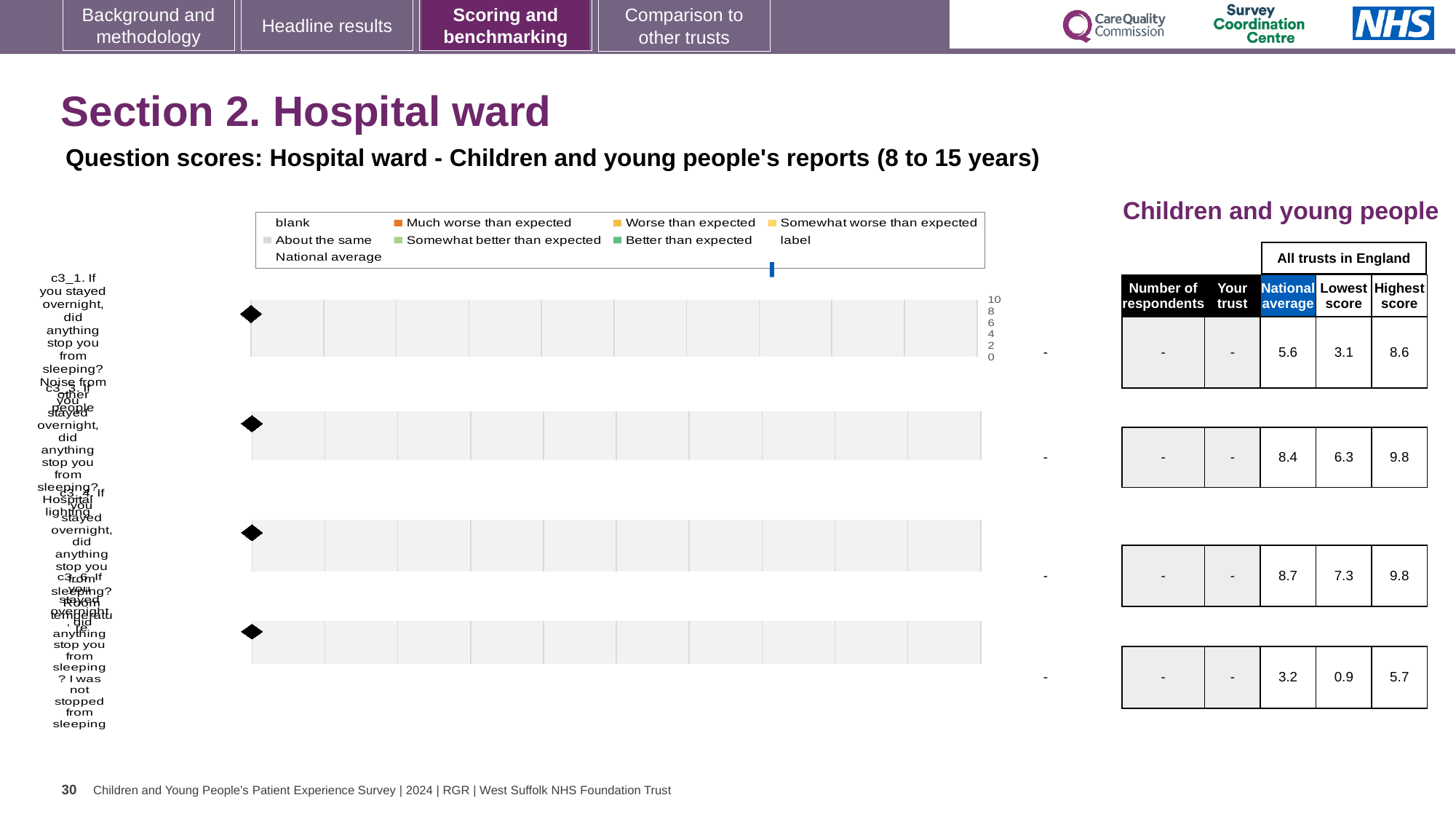
What is the highest value shown on the chart's score axis? 10 In the table beside the chart, what is the highest score for the second row (c3_3, hospital lighting)? 9.8 Which legend entry is shown with a dark green marker? Better than expected What kind of chart is shown on the slide? bar chart In the table beside the chart, what is the difference between the highest score and the lowest score for the third row (c3_4, room temperature)? 2.5 How many question categories (bars) are plotted in the chart? 4 In the table beside the chart, what is the lowest score for the fourth row (c3_6, I was not stopped from sleeping)? 0.9 In the table beside the chart, what is the national average for the first row (c3_1, noise from other people)? 5.6 In the table beside the chart, which row has the highest national average? c3_4 (room temperature), 8.7 How many entries does the chart legend list? 9 In the table beside the chart, is the national average for the first row (c3_1) larger or smaller than that for the second row (c3_3)? smaller In the table beside the chart, which row has the lowest national average? c3_6 (I was not stopped from sleeping), 3.2